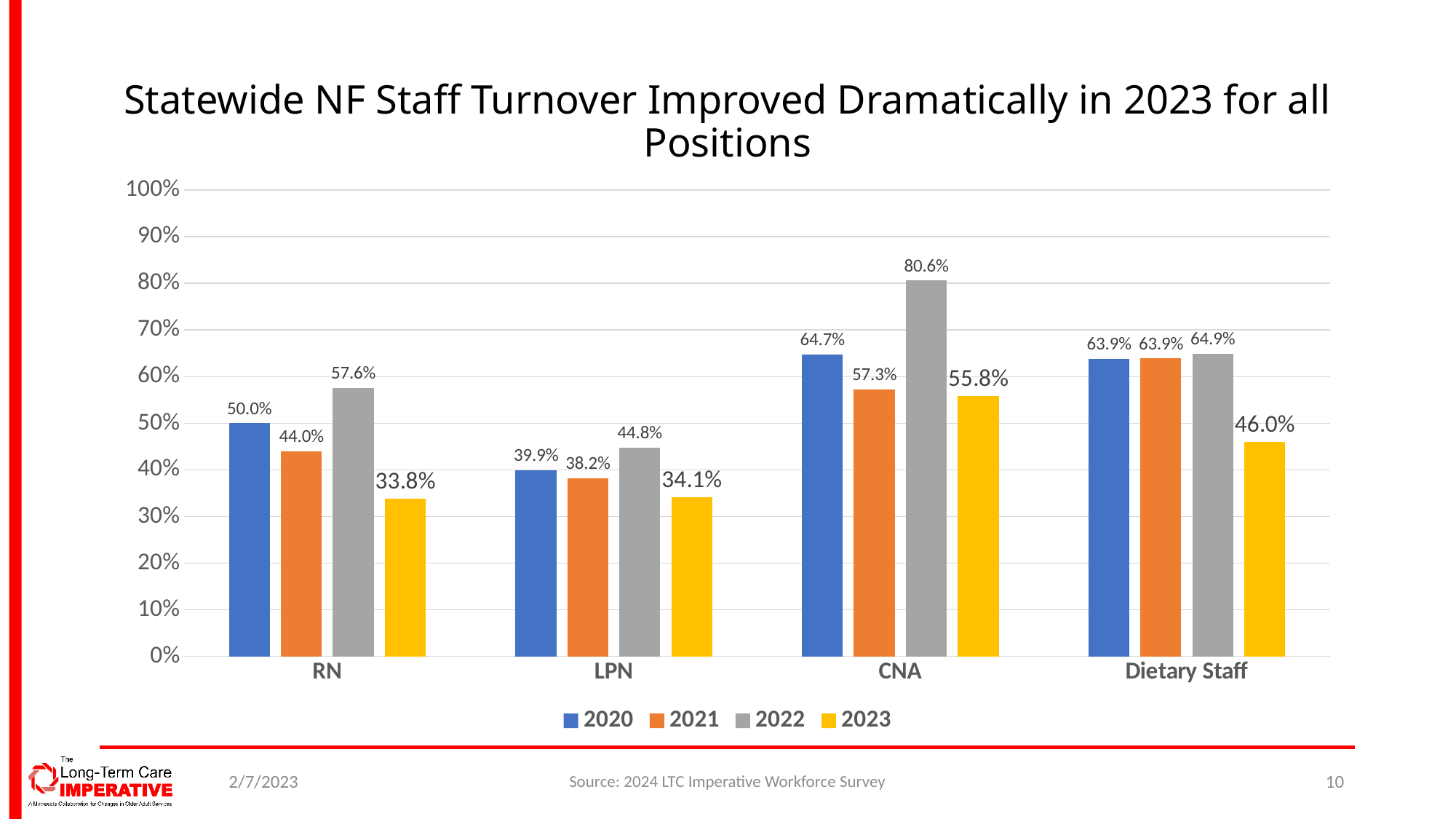
Which position has the highest 2022 turnover value? CNA How many positions are shown on the x axis? 4 How many series does the legend list? 4 What is the 2023 turnover value for CNA? 55.8% Which is larger, the 2020 turnover for Dietary Staff or the 2020 turnover for CNA? CNA What kind of chart is shown on the slide? Bar chart What is the difference between the 2020 and 2021 turnover values for RN? 6.0% Is the 2022 turnover value for CNA greater or less than 80%? greater What is the 2022 turnover value for RN? 57.6% What is the 2021 turnover value for LPN? 38.2% Which position has the lowest 2023 turnover value? RN What is the difference between the 2022 and 2023 turnover values for CNA? 24.8%